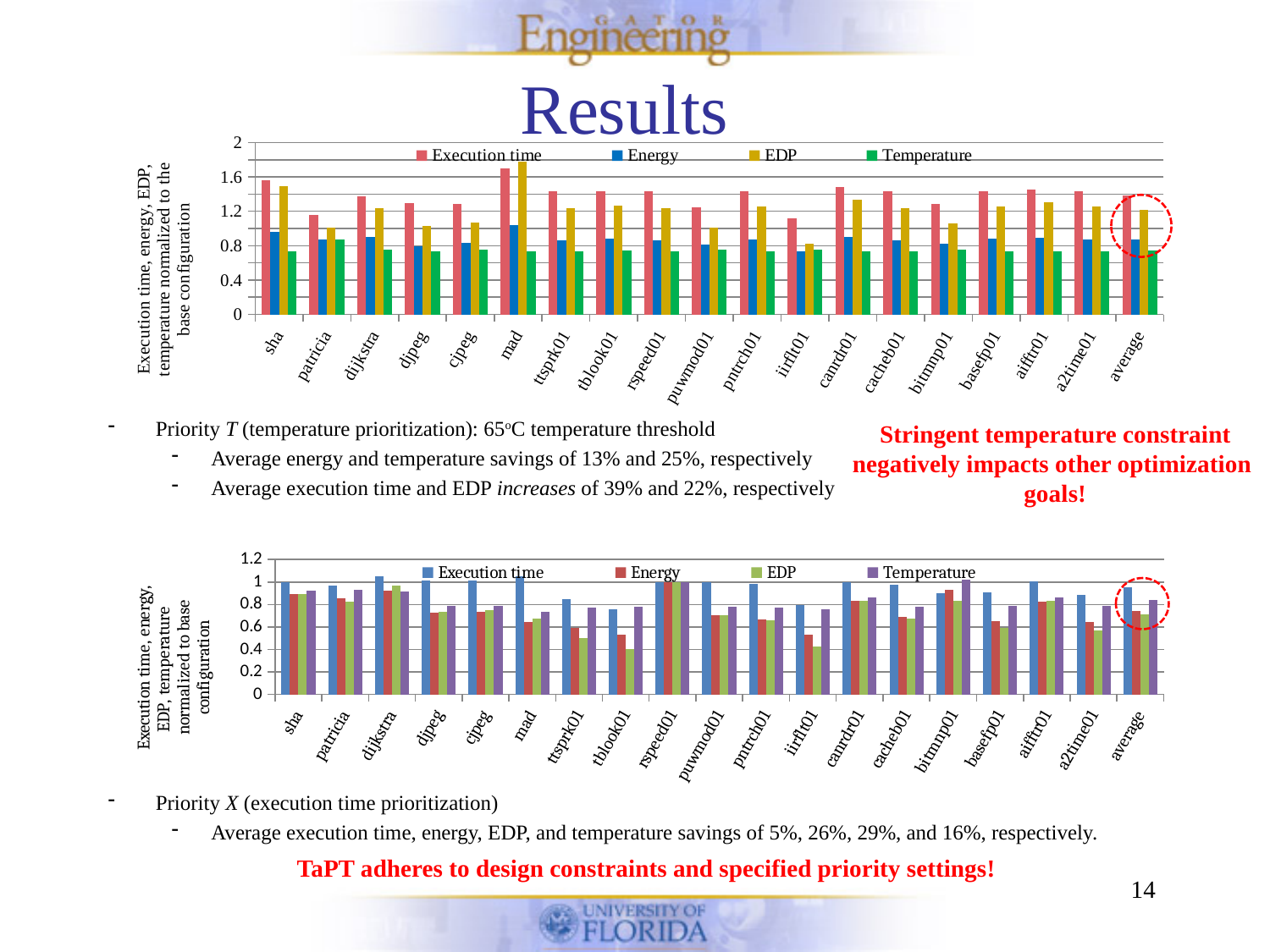
In the bottom chart, is the Execution time value for dijkstra greater or less than 0.8? greater What are the four legend entries of the bottom chart? Execution time, Energy, EDP, Temperature In the top chart, which category has the highest EDP value? mad In the top chart, which is larger: the EDP value for mad or the EDP value for patricia? mad In the top chart, is the Execution time value for iirflt01 greater or less than 1.2? less How many series does the legend of the top chart list? 4 In the top chart, is the Temperature value for sha greater or less than 1? less What kind of chart is the top chart on the slide? bar chart In the bottom chart, which is larger: the Execution time value for sha or the Energy value for sha? Execution time How many categories are shown along the x axis of the bottom chart? 19